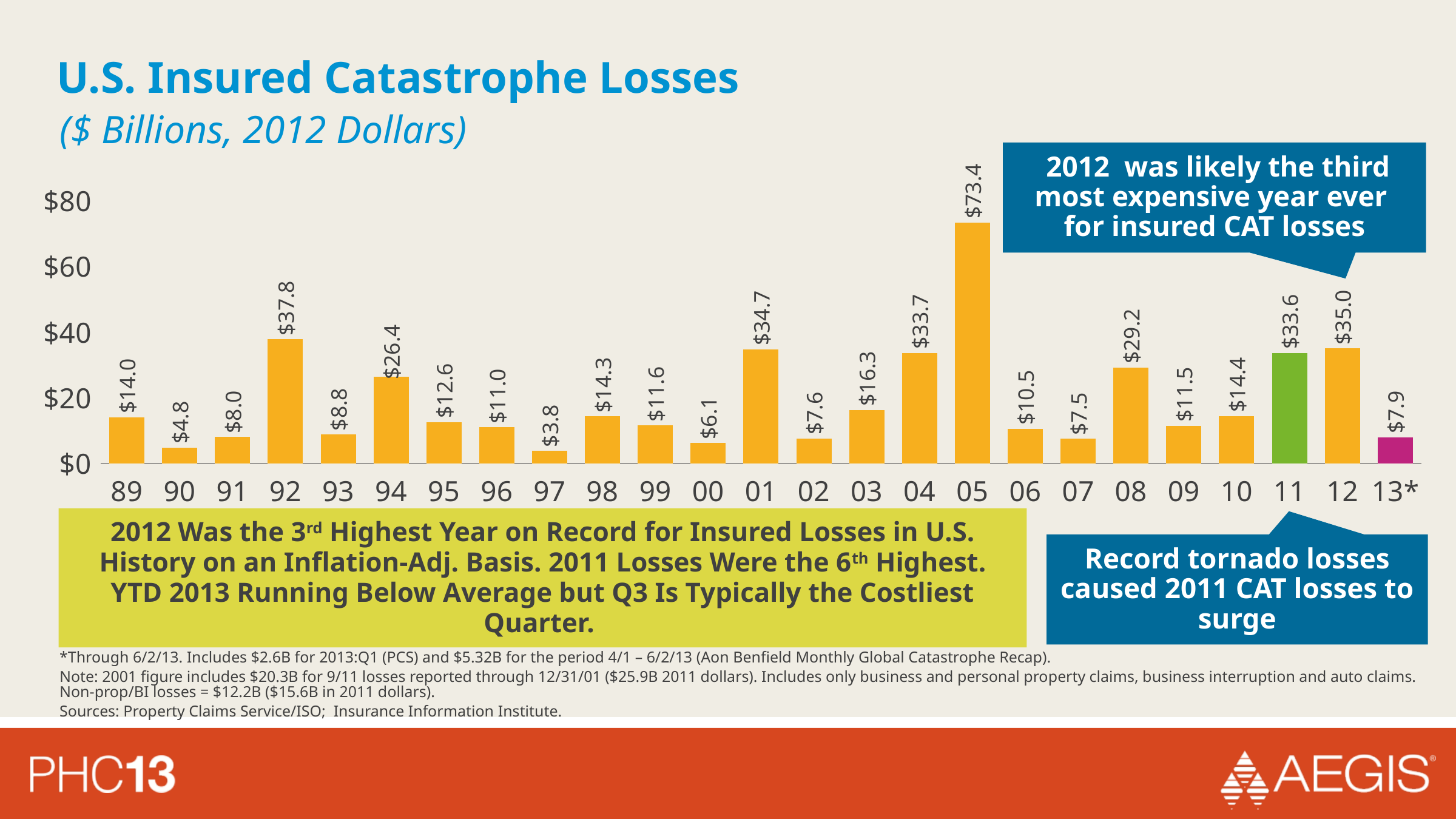
What is the value for 13*? $7.9 What kind of chart is shown on the slide? Bar chart How many years (bars) are shown on the chart? 25 Which is larger, the value for 1992 (92) or the value for 2012 (12)? 92 What colour is the bar for 2011 (11)? Green Which year has the highest insured catastrophe losses? 05 What is the total of the values for 2004 (04) and 2005 (05)? $107.1 Which year has the lowest insured catastrophe losses? 97 What is the difference between the values for 2012 (12) and 2011 (11)? $1.4 What is the value for 2011 (11)? $33.6 Is the value for 2008 (08) greater or less than $20? greater What is the value for 2005 (05)? $73.4